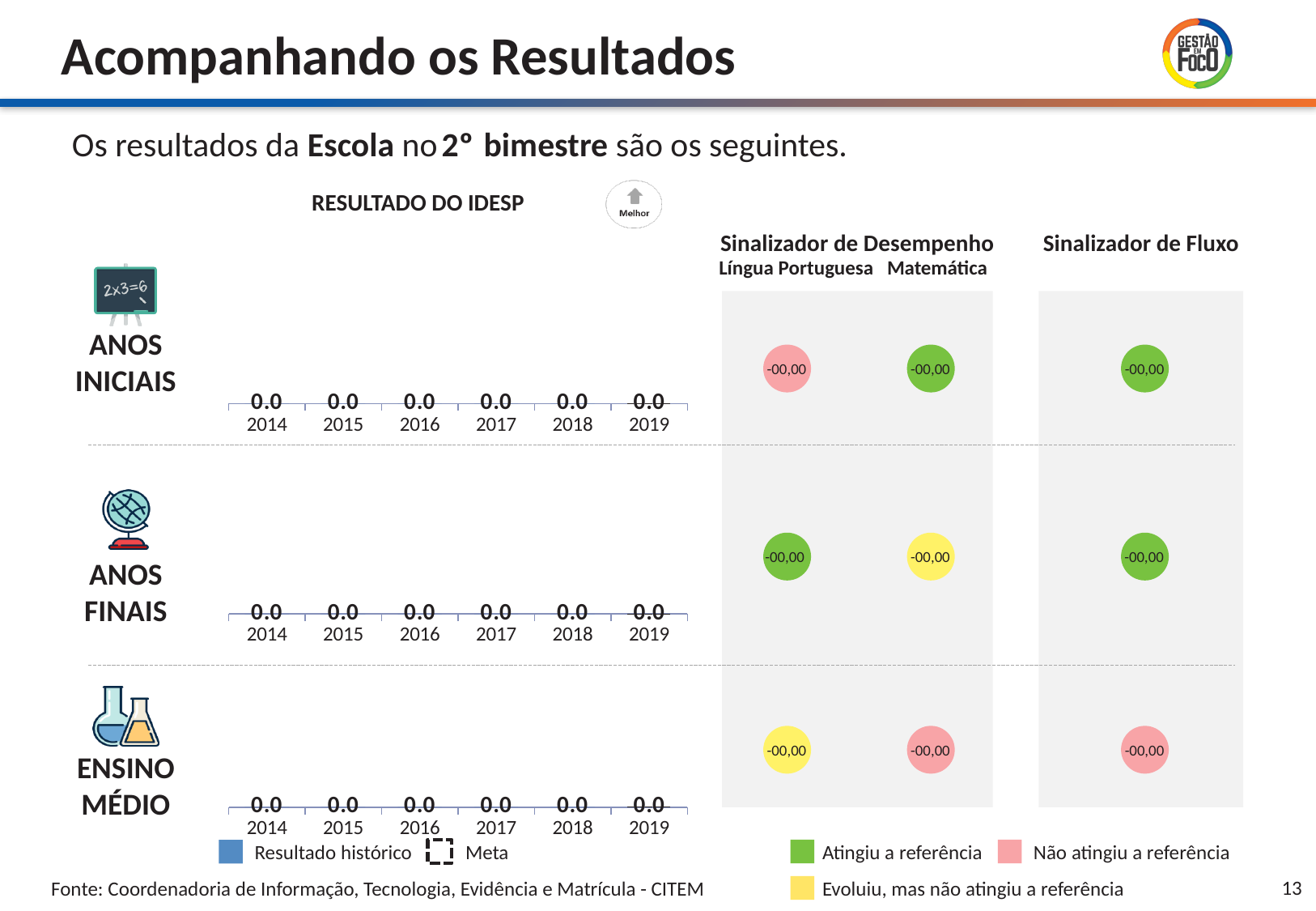
In the ANOS FINAIS chart, what is the last year shown on the x axis? 2019 What is the title shown above the three charts on the left? RESULTADO DO IDESP In the ENSINO MÉDIO chart, what is the value for 2015? 0.0 In the ANOS FINAIS chart, do the values rise, fall, or stay the same from 2014 to 2019? stay the same In the ENSINO MÉDIO chart, what is the first year shown on the x axis? 2014 What are the two legend entries shown below the ENSINO MÉDIO chart? Resultado histórico and Meta In the ANOS FINAIS chart, what is the value for 2019? 0.0 In the ANOS INICIAIS chart, how many years are shown on the x axis? 6 In the ENSINO MÉDIO chart, what is the value for 2017? 0.0 In the ANOS INICIAIS chart, what is the value for 2014? 0.0 How many series does the legend below the ENSINO MÉDIO chart list? 2 In the ANOS INICIAIS chart, what is the difference between the values for 2019 and 2014? 0.0